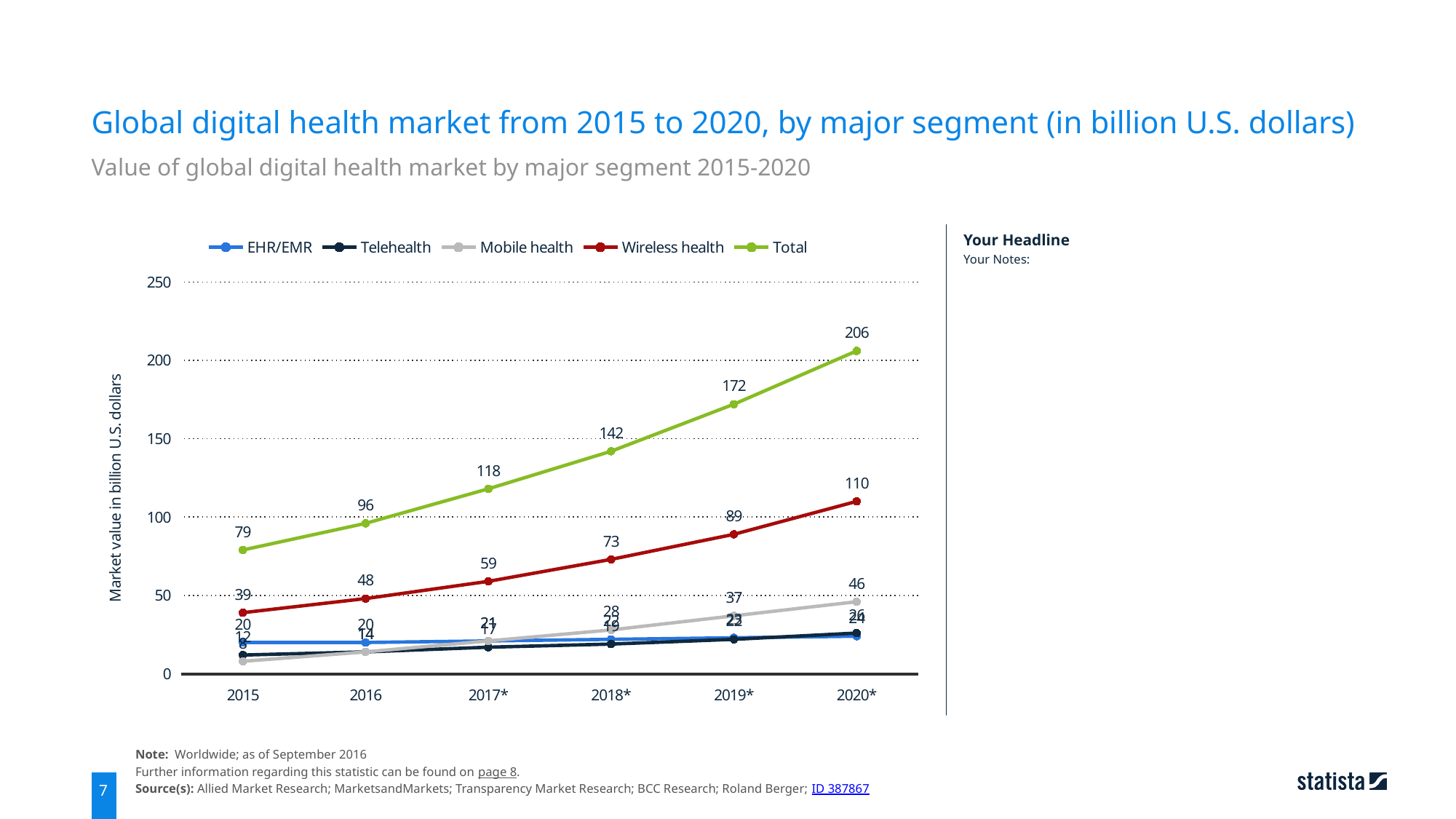
By how much does the Total value in 2020* exceed the Total value in 2015? 127 How many years are plotted along the x axis? 6 What is the value of Mobile health in 2019*? 37 In which year is the Total series highest? 2020* What is the value of the Total series for 2020*? 206 Does the Total series rise or fall from 2015 to 2020*? rise What kind of chart is shown on the slide? line chart How many series does the legend list? 5 In 2019*, which is larger: Wireless health or Mobile health? Wireless health What is the value of Wireless health in 2018*? 73 What is the label of the y axis? Market value in billion U.S. dollars In which year is Wireless health lowest? 2015